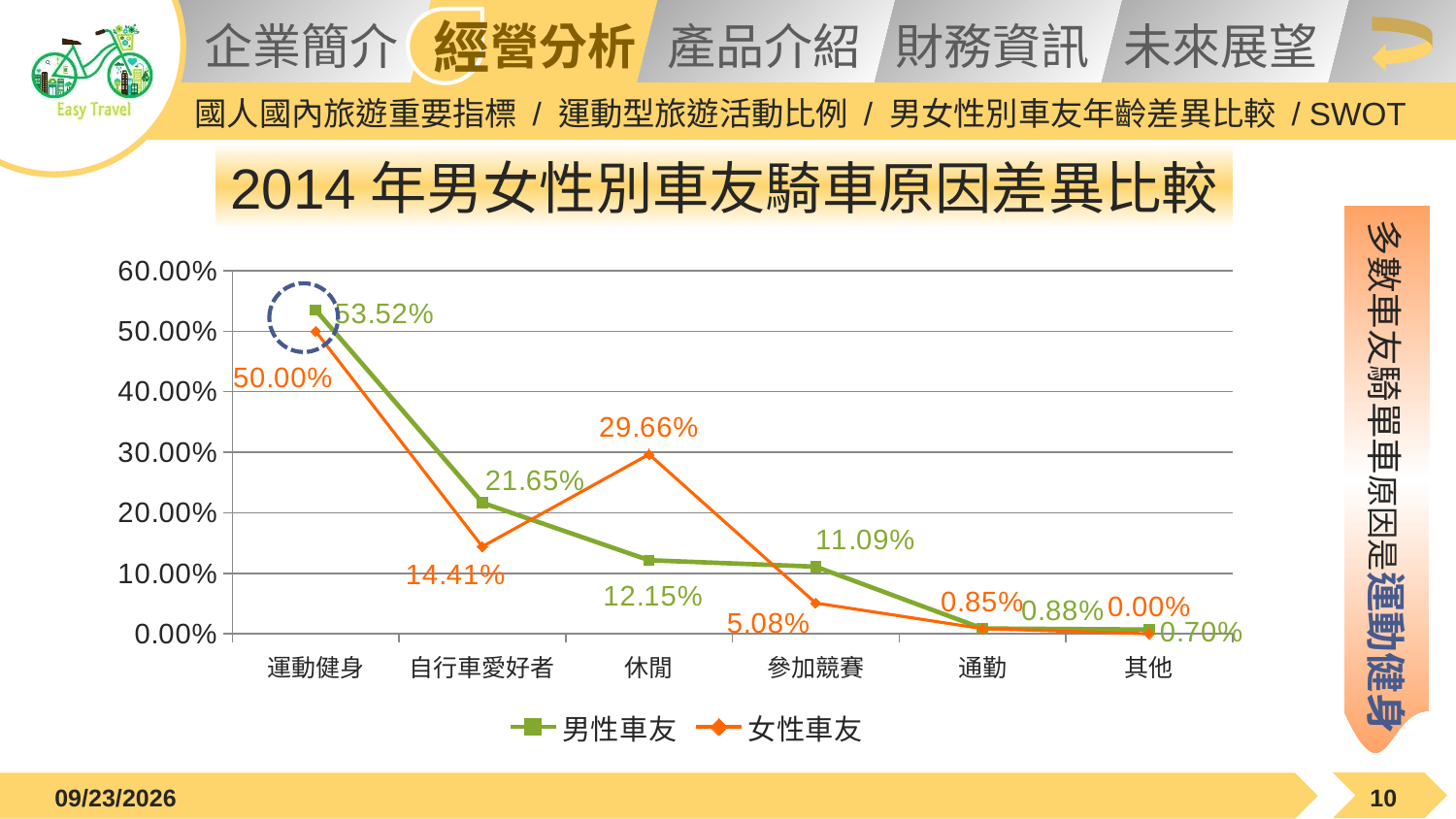
What is the value for 男性車友 in the 自行車愛好者 category? 21.65% What is the value for 女性車友 in the 休閒 category? 29.66% What is the title of the chart? 2014 年男女性別車友騎車原因差異比較 How many categories are shown on the x axis? 6 How many series does the legend list? 2 What is the value for 男性車友 in the 運動健身 category? 53.52% What is the difference between 女性車友 and 男性車友 in the 休閒 category? 17.51% What is the value for 女性車友 in the 參加競賽 category? 5.08% What is the value for 女性車友 in the 運動健身 category? 50.00% In the 自行車愛好者 category, which series has the larger value, 男性車友 or 女性車友? 男性車友 Which category has the highest value for 男性車友? 運動健身 What kind of chart is shown on the slide? line chart